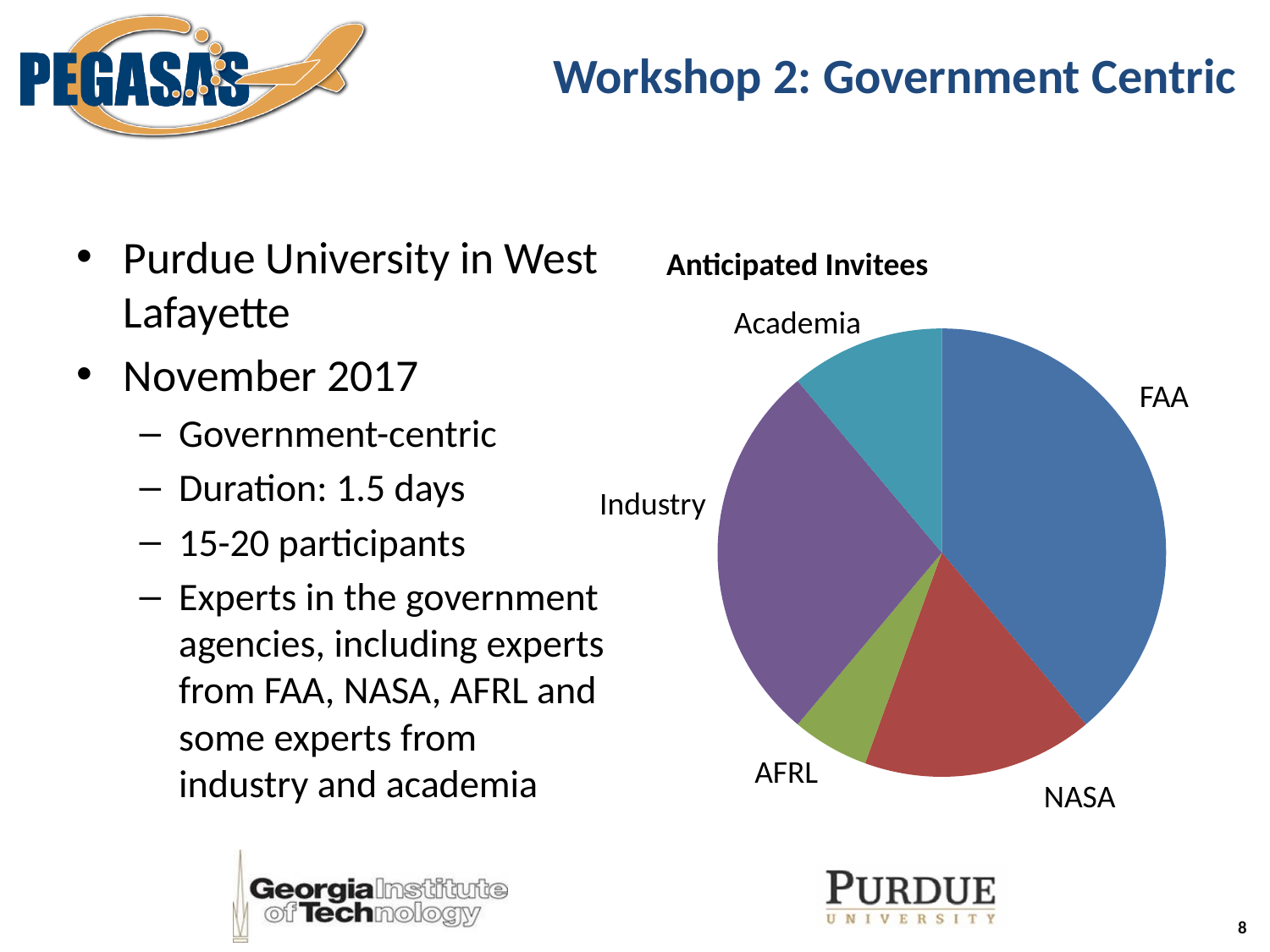
Which category is shown in the blue slice of the pie? FAA Which category has the smallest slice of the pie? AFRL Which slice is larger, FAA or NASA? FAA Which slice is larger, Academia or AFRL? Academia Which slice is larger, Industry or Academia? Industry Which category has the largest slice of the pie? FAA What kind of chart is shown on the slide? pie chart What is the title of the chart? Anticipated Invitees How many slices does the pie chart have? 5